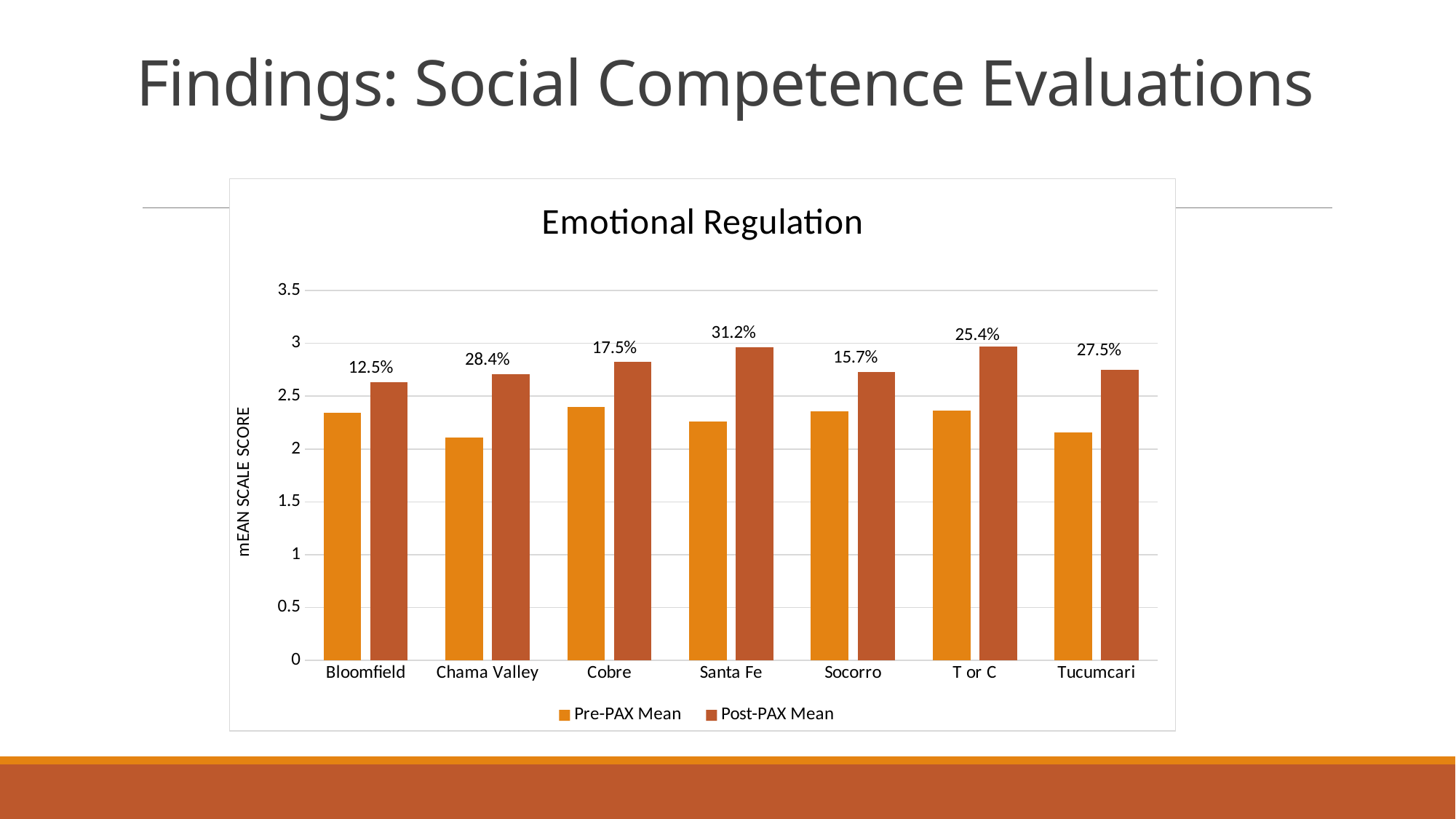
What percentage label is shown above the Post-PAX Mean bar for Bloomfield? 12.5% What percentage label is shown above the Post-PAX Mean bar for Santa Fe? 31.2% What percentage label is shown for Tucumcari? 27.5% Which site has the highest percentage label? Santa Fe How many categories (sites) are shown on the x axis? 7 What type of chart is shown on the slide? Bar chart Is the Pre-PAX Mean value for Chama Valley greater or less than 2.5? less What is the title of the chart? Emotional Regulation Which is larger, the Pre-PAX Mean for Cobre or the Pre-PAX Mean for Chama Valley? Cobre How many series does the legend list? 2 What is the difference between the percentage labels for Santa Fe and Bloomfield? 18.7 percentage points Which site has the lowest percentage label? Bloomfield